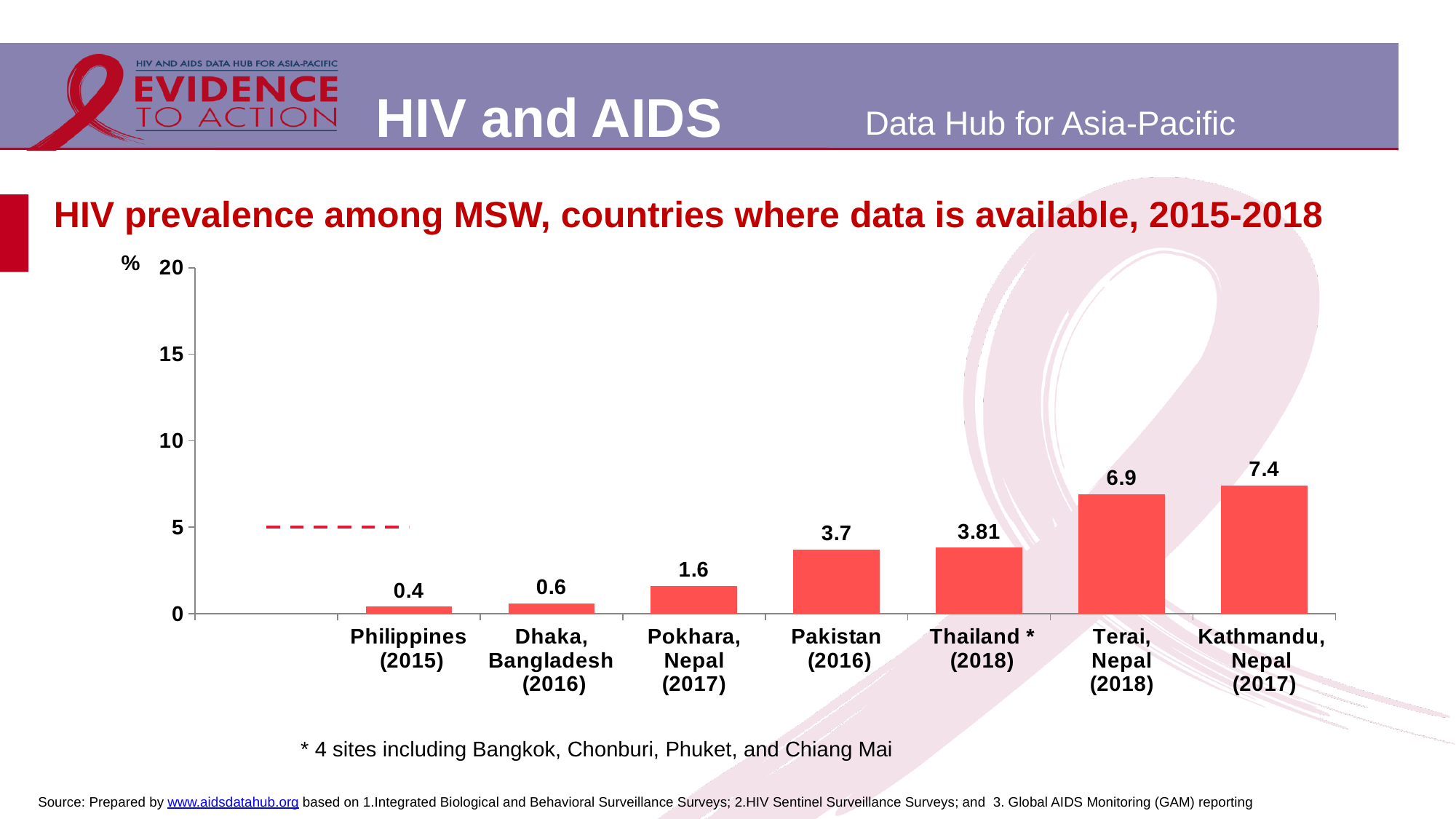
What type of chart is shown on the slide? Bar chart What is the HIV prevalence among MSW in Kathmandu, Nepal (2017)? 7.4 Which category has the lowest HIV prevalence among MSW? Philippines (2015) What is the difference in HIV prevalence between Pokhara, Nepal (2017) and Dhaka, Bangladesh (2016)? 1.0 What unit is shown on the y axis of the chart? % What is the HIV prevalence among MSW in Thailand (2018)? 3.81 What is the HIV prevalence among MSW in Pakistan (2016)? 3.7 What is the difference in HIV prevalence between Kathmandu, Nepal (2017) and Terai, Nepal (2018)? 0.5 Which has a higher HIV prevalence among MSW: Terai, Nepal (2018) or Pakistan (2016)? Terai, Nepal (2018) Is the HIV prevalence for Terai, Nepal (2018) greater or less than 5? greater How many countries or sites are shown in the chart? 7 Which category has the highest HIV prevalence among MSW? Kathmandu, Nepal (2017)